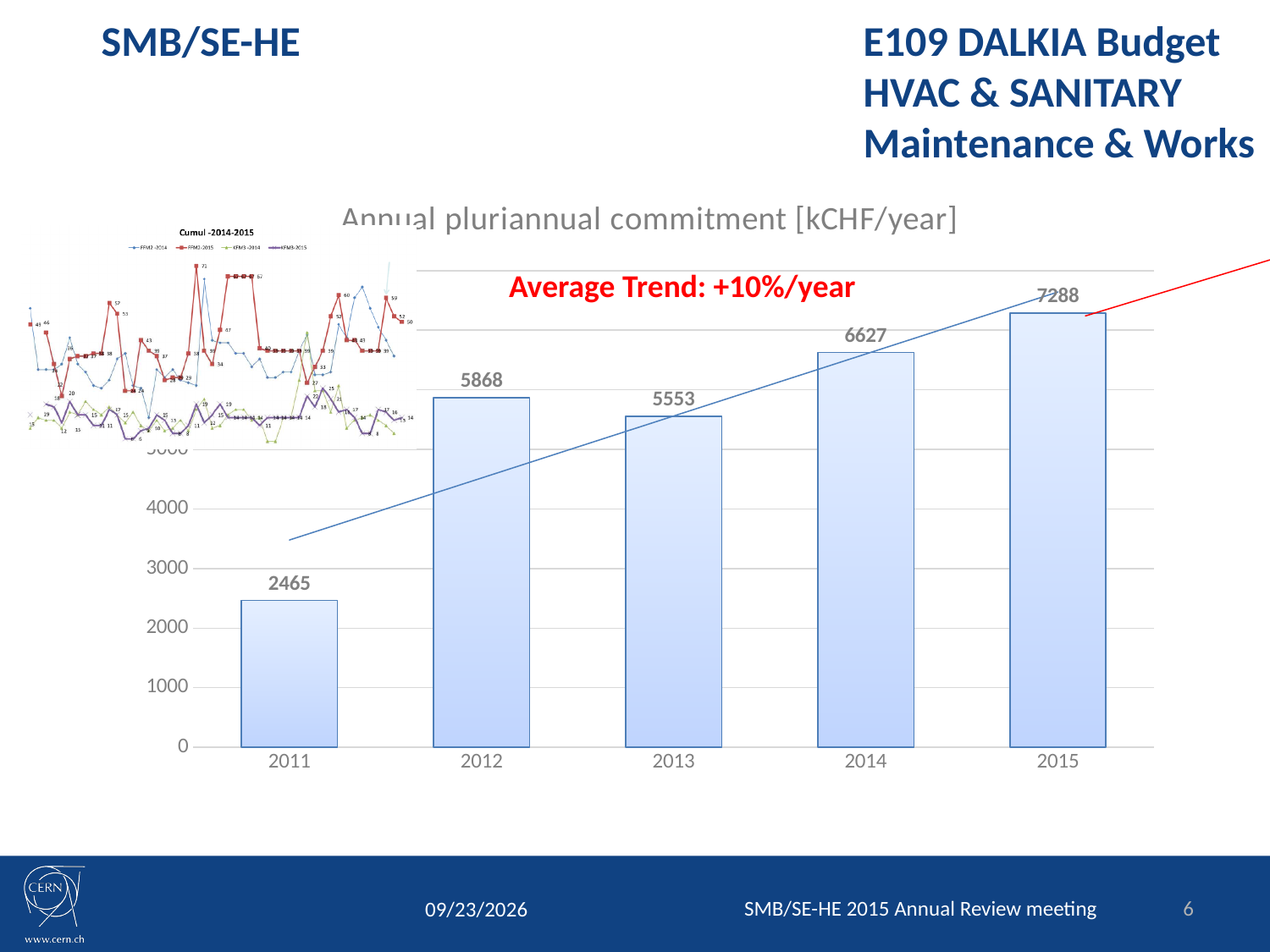
In the 'Annual pluriannual commitment [kCHF/year]' chart, which is larger, the value for 2012 or the value for 2013? 2012 In the 'Annual pluriannual commitment [kCHF/year]' chart, what is the value for 2015? 7288 In the 'Annual pluriannual commitment [kCHF/year]' chart, is the value for 2014 greater or less than 6000? greater In the 'Annual pluriannual commitment [kCHF/year]' chart, what is the difference between the 2012 and 2013 values? 315 How many years are shown on the x axis of the 'Annual pluriannual commitment [kCHF/year]' chart? 5 In the 'Annual pluriannual commitment [kCHF/year]' chart, which year has the lowest value? 2011 What average trend is annotated on the 'Annual pluriannual commitment [kCHF/year]' chart? +10%/year In the 'Annual pluriannual commitment [kCHF/year]' chart, what is the difference between the 2015 and 2014 values? 661 In the 'Annual pluriannual commitment [kCHF/year]' chart, what is the value for 2011? 2465 What kind of chart is the 'Annual pluriannual commitment [kCHF/year]' chart? Bar chart In the 'Annual pluriannual commitment [kCHF/year]' chart, what is the value for 2013? 5553 In the 'Annual pluriannual commitment [kCHF/year]' chart, which year has the highest value? 2015